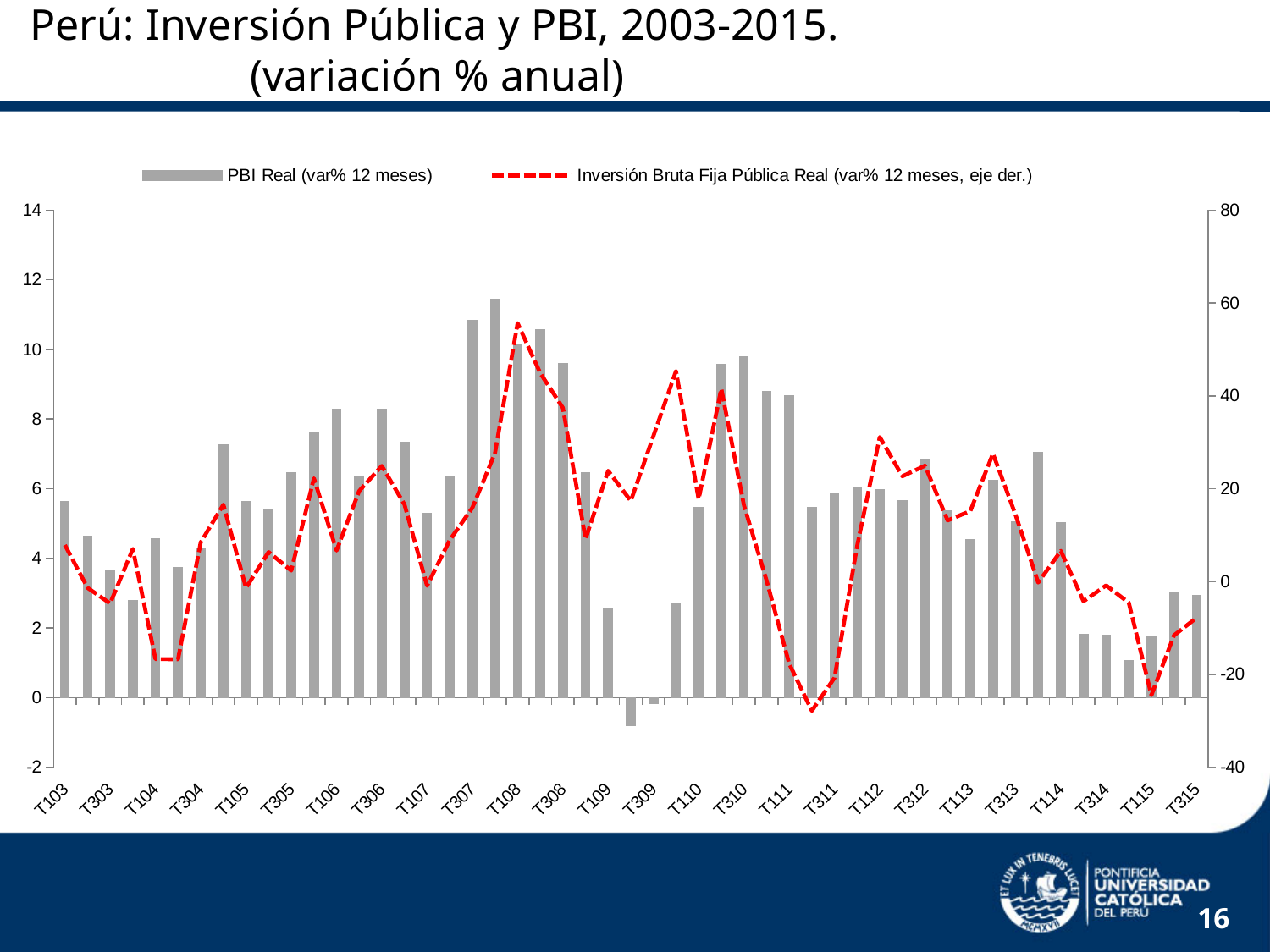
What kind of chart is this? Combined bar and line chart Which series is plotted as grey bars? PBI Real (var% 12 meses) Is the PBI Real value for T309 greater or less than 0? less Do the PBI Real bars rise or fall from T108 to T309? fall At which quarter is the PBI Real bar the highest? T407 At which quarter is the PBI Real bar the lowest? T209 How many series does the legend list? 2 Is the Inversión Bruta Fija Pública Real value for T108 greater or less than 40 on the right axis? greater Which series is drawn as a red dashed line? Inversión Bruta Fija Pública Real (var% 12 meses, eje der.) Is the PBI Real value for T115 greater or less than 2? less Which has the larger PBI Real bar, T307 or T310? T307